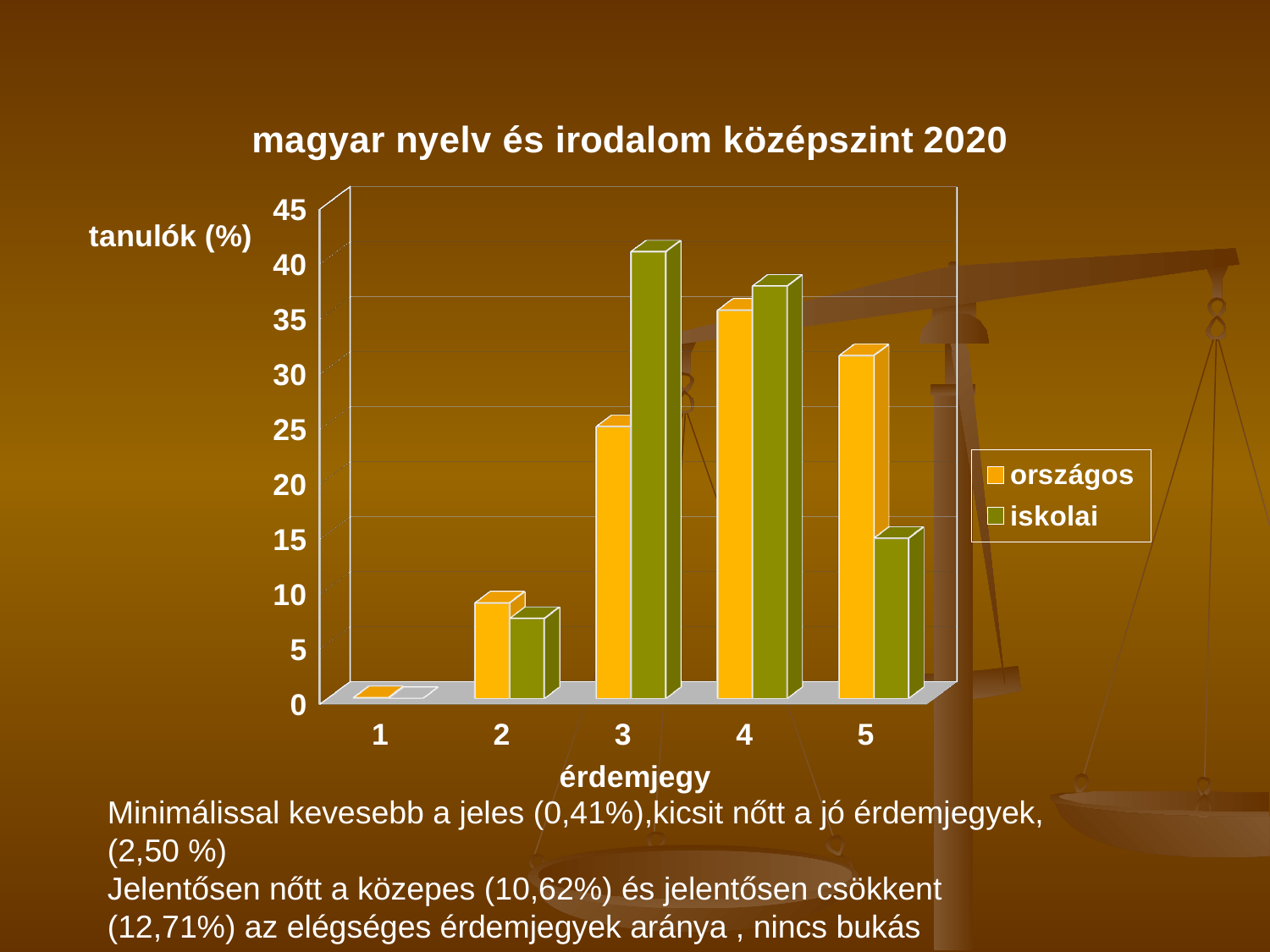
Is the iskolai value for grade 3 greater or less than 35? greater Is the iskolai value for grade 5 greater or less than 20? less How many series does the legend list? 2 What kind of chart is shown on the slide? bar chart What is the title of the chart? magyar nyelv és irodalom középszint 2020 Which colour represents the iskolai series in the legend? green For grade 5, which series has the larger value, országos or iskolai? országos For which grade is the országos value lowest? 1 For which grade is the iskolai value highest? 3 How many grade categories (érdemjegy) are shown on the x axis? 5 For grade 3, which series has the larger value, országos or iskolai? iskolai Is the országos value for grade 3 greater or less than 30? less